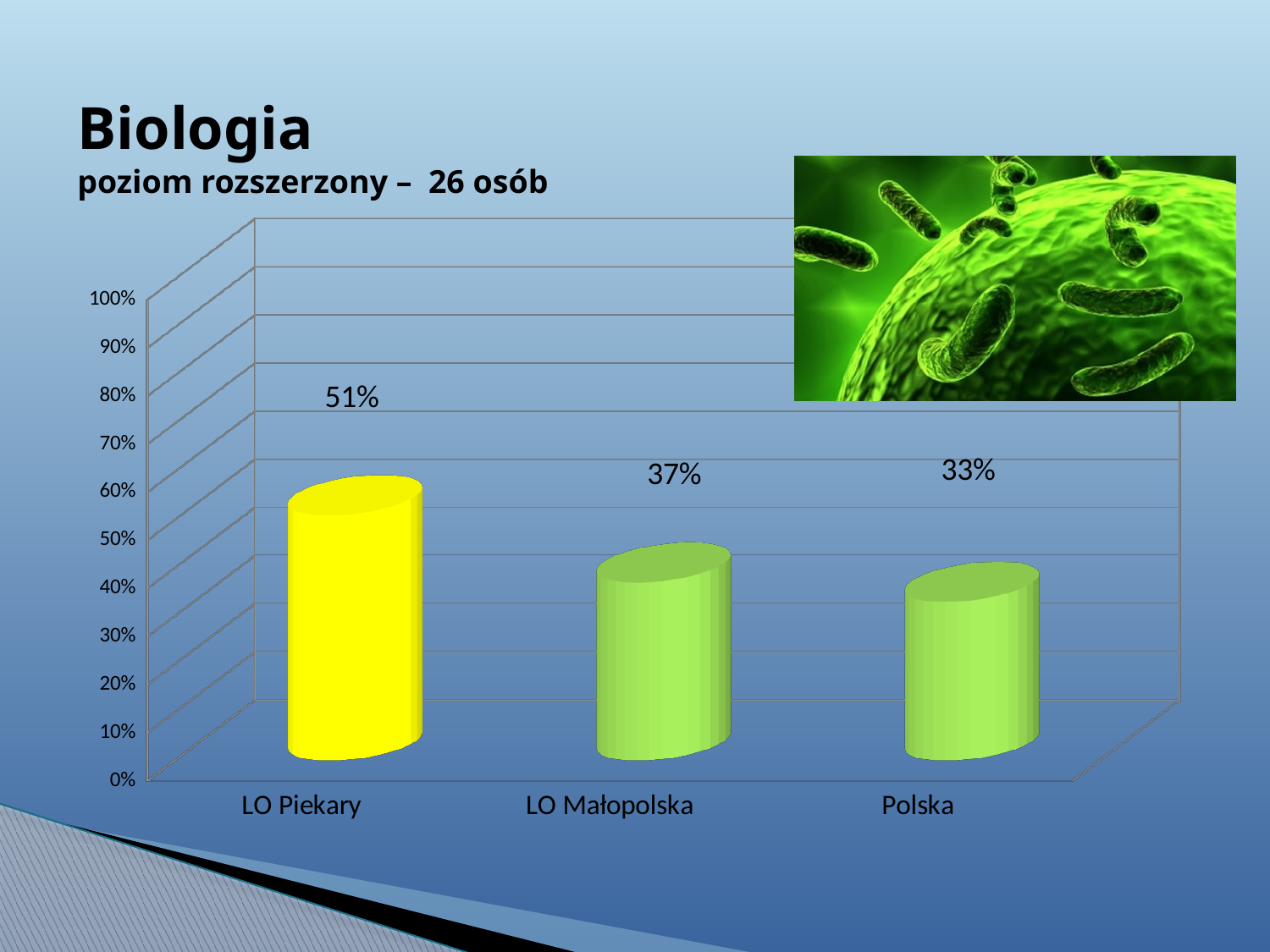
Which is larger, the value for LO Piekary or the value for LO Małopolska? LO Piekary Which category has the highest value? LO Piekary Is the value for LO Piekary greater or less than 50%? greater What is the value for Polska? 33% What is the value for LO Piekary? 51% What is the difference between the values for LO Małopolska and Polska? 4% What kind of chart is shown on the slide? bar chart How many categories are shown on the x axis? 3 Do the values rise or fall from left to right along the x axis? fall Which category has the lowest value? Polska What is the value for LO Małopolska? 37% What is the difference between the values for LO Piekary and Polska? 18%